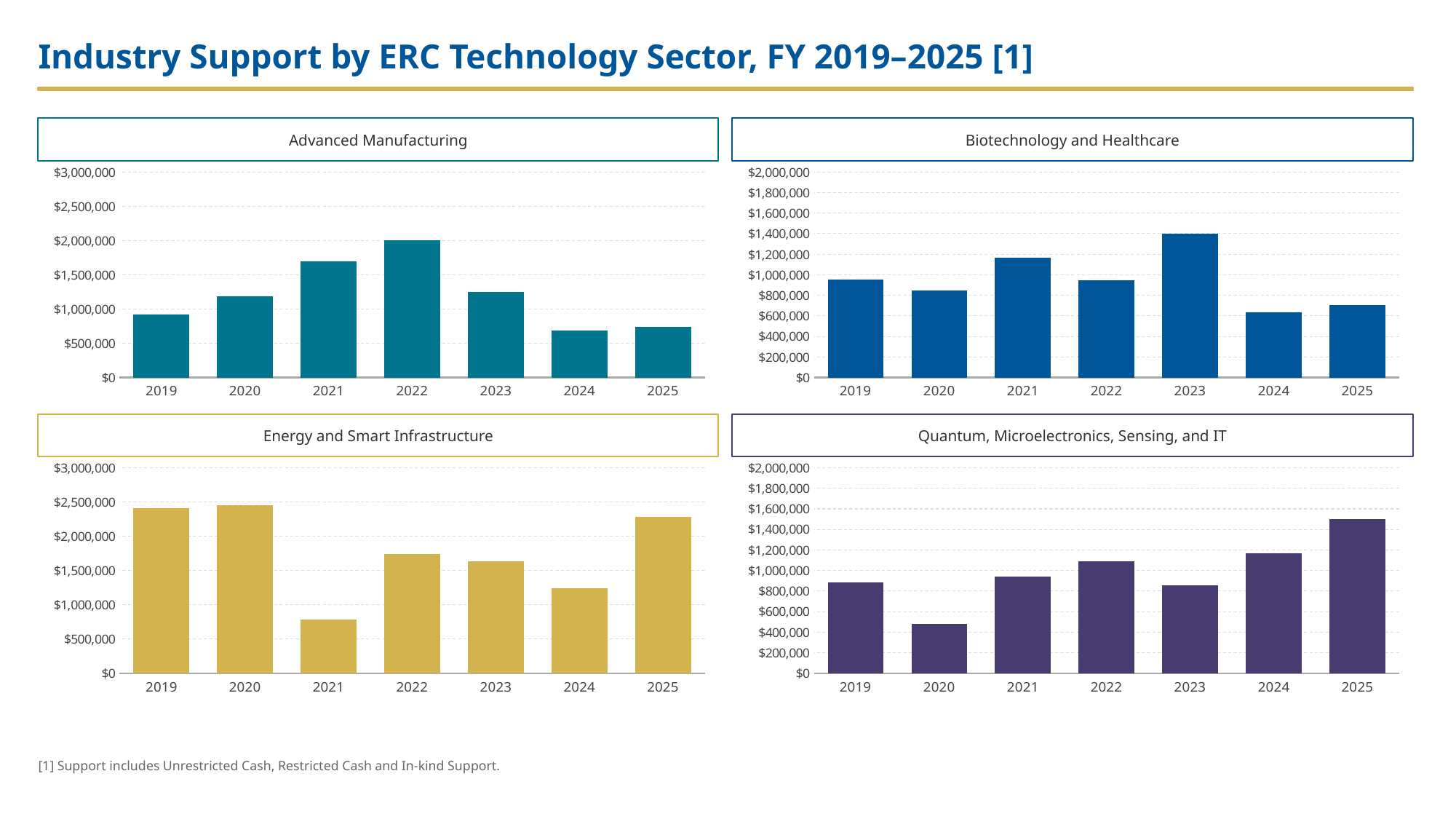
In the Quantum, Microelectronics, Sensing, and IT chart, which year has the lowest value? 2020 In the Advanced Manufacturing chart, is the value for 2019 greater or less than $1,000,000? less In the Quantum, Microelectronics, Sensing, and IT chart, which is larger, the value for 2022 or the value for 2023? 2022 In the Quantum, Microelectronics, Sensing, and IT chart, which year has the highest value? 2025 How many charts are shown on the slide? 4 In the Advanced Manufacturing chart, which year has the highest value? 2022 In the Energy and Smart Infrastructure chart, which year has the lowest value? 2021 In the Biotechnology and Healthcare chart, is the value for 2021 greater or less than $1,000,000? greater What kind of chart is the Advanced Manufacturing chart? bar chart In the Biotechnology and Healthcare chart, which year has the highest value? 2023 How many years are shown on the x axis of the Energy and Smart Infrastructure chart? 7 In the Energy and Smart Infrastructure chart, is the value for 2025 greater or less than $2,000,000? greater